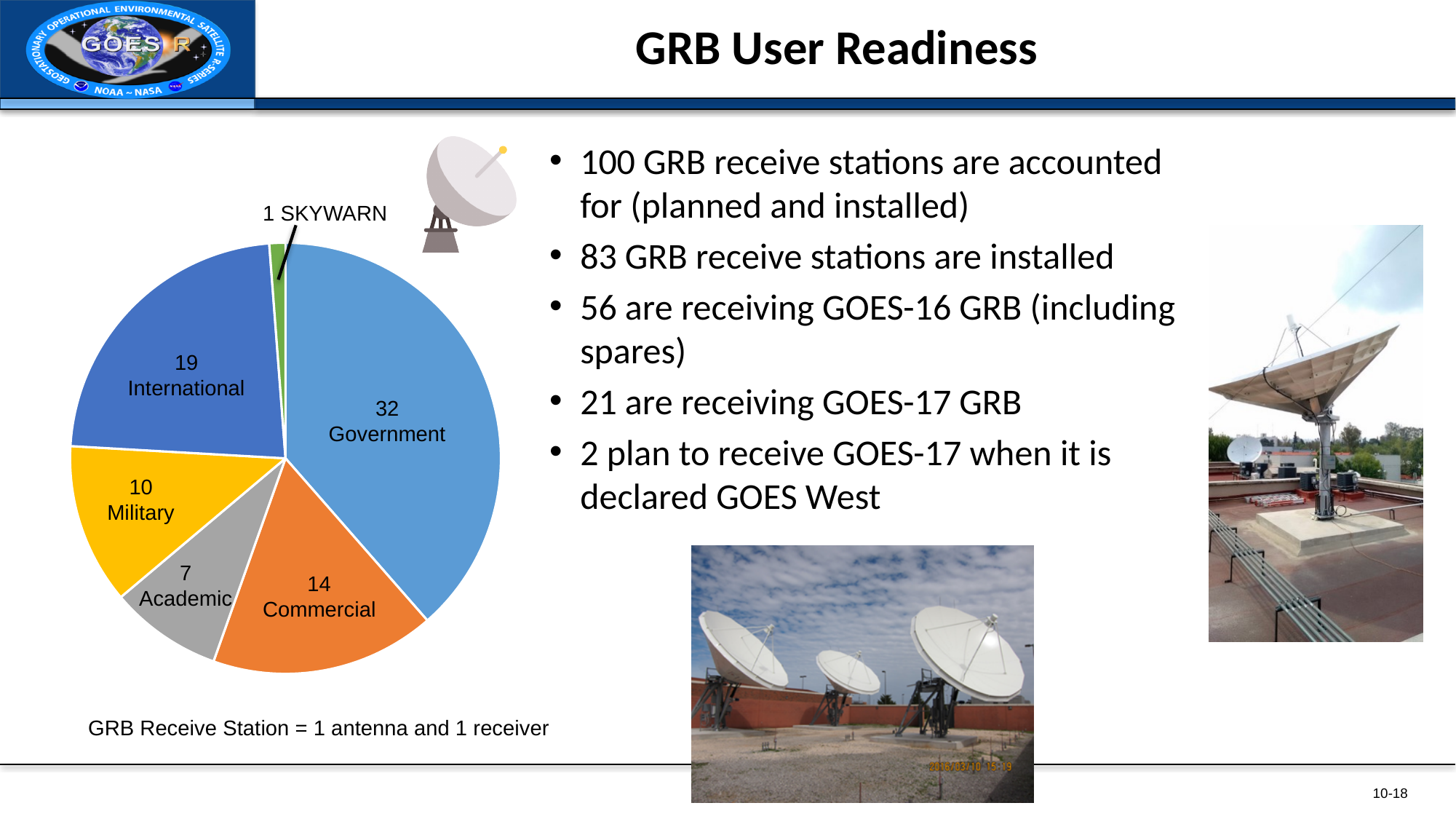
What is the value for International in the pie chart? 19 How many slices does the pie chart have? 6 What is the value for Military in the pie chart? 10 What is the difference between the Government and International values in the pie chart? 13 Which is larger in the pie chart, Commercial or Military? Commercial What is the value for Academic in the pie chart? 7 What is the total of all slices in the pie chart? 83 Which category has the smallest slice in the pie chart? SKYWARN Which category has the largest slice in the pie chart? Government What kind of chart is shown on the slide? pie chart What is the value for Commercial in the pie chart? 14 What is the value for Government in the pie chart? 32